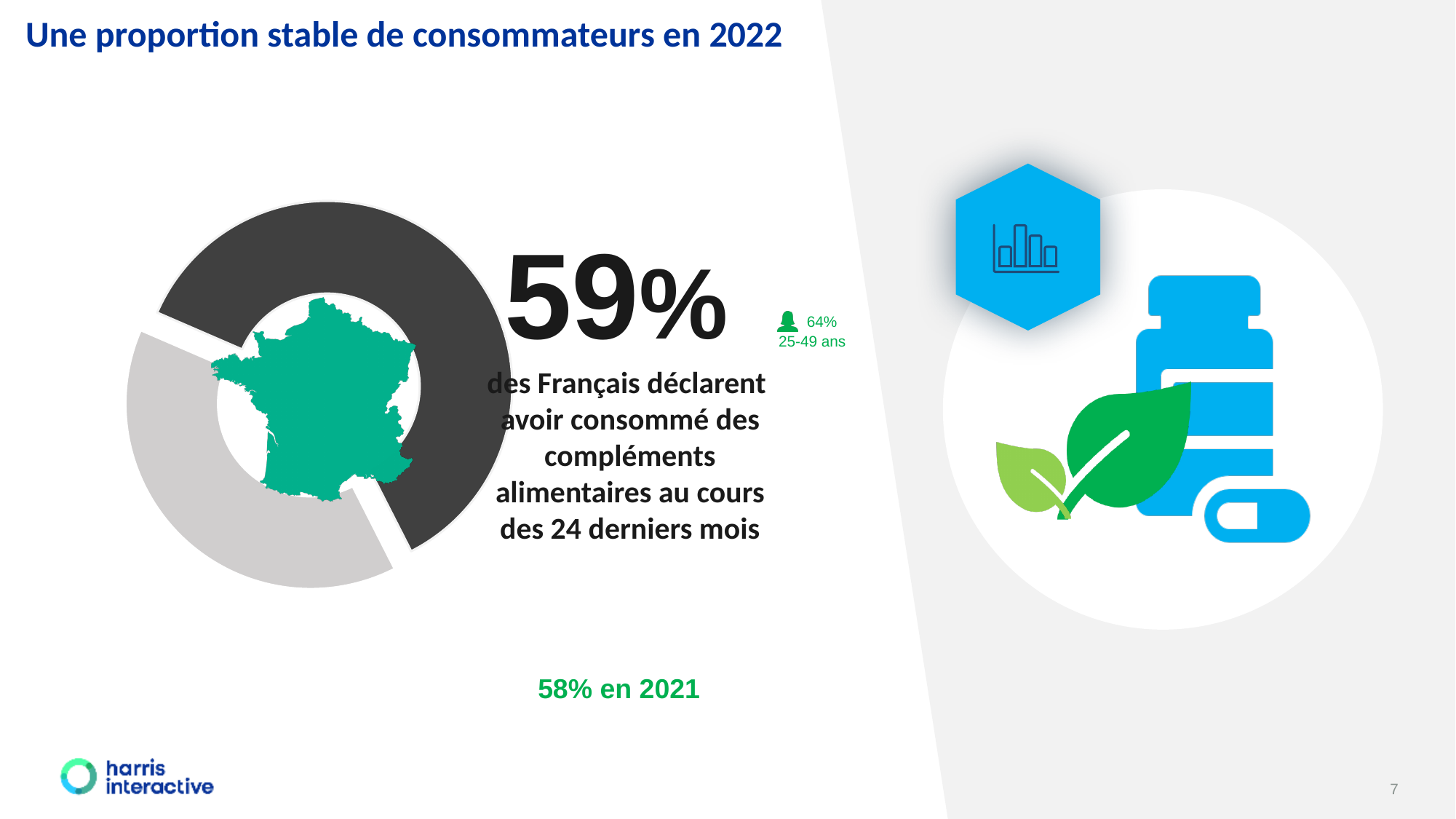
What is the title of the slide? Une proportion stable de consommateurs en 2022 What was the proportion of consumers in 2021, as shown below the chart? 58% How many segments does the donut chart have? 2 Which segment of the donut chart is larger, the dark grey one or the light grey one? The dark grey one By how many percentage points did the proportion of consumers change between 2021 (58%) and 2022 (59%)? 1 point Is the value for the 25-49 ans group greater or less than the overall 59%? Greater Is the 2022 proportion (59%) higher or lower than the 2021 proportion (58%)? Higher What percentage of French people declare having consumed food supplements in the last 24 months, according to the donut chart? 59% What image is displayed in the centre of the donut chart? A green map of France What percentage is shown for the 25-49 ans age group next to the chart? 64% What kind of chart is shown on the left of the slide? Donut (pie) chart